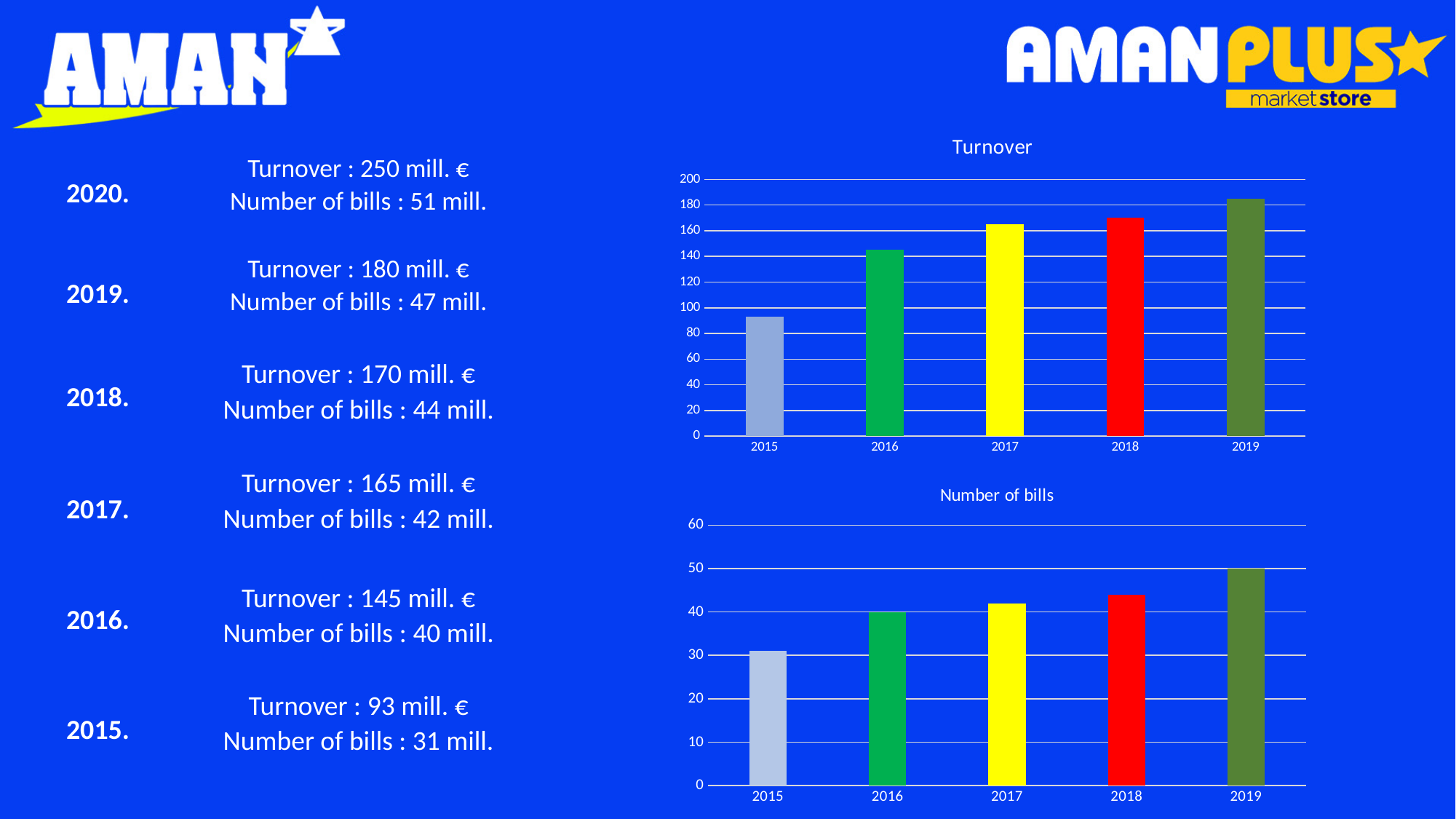
What is the title of the lower chart on the slide? Number of bills In the Turnover chart, is the value for 2015 greater or less than 100? less In the Turnover chart, which year has the lowest bar? 2015 In the Number of bills chart, is the value for 2015 greater or less than 40? less In the Number of bills chart, which is larger, the bar for 2016 or the bar for 2018? 2018 In the Turnover chart, do the values rise or fall from 2015 to 2019? rise In the Number of bills chart, do the values rise or fall from 2015 to 2019? rise In the Number of bills chart, which year has the highest bar? 2019 What type of chart is the Turnover chart? bar chart In the Turnover chart, which year has the highest bar? 2019 How many years are shown on the x axis of the Turnover chart? 5